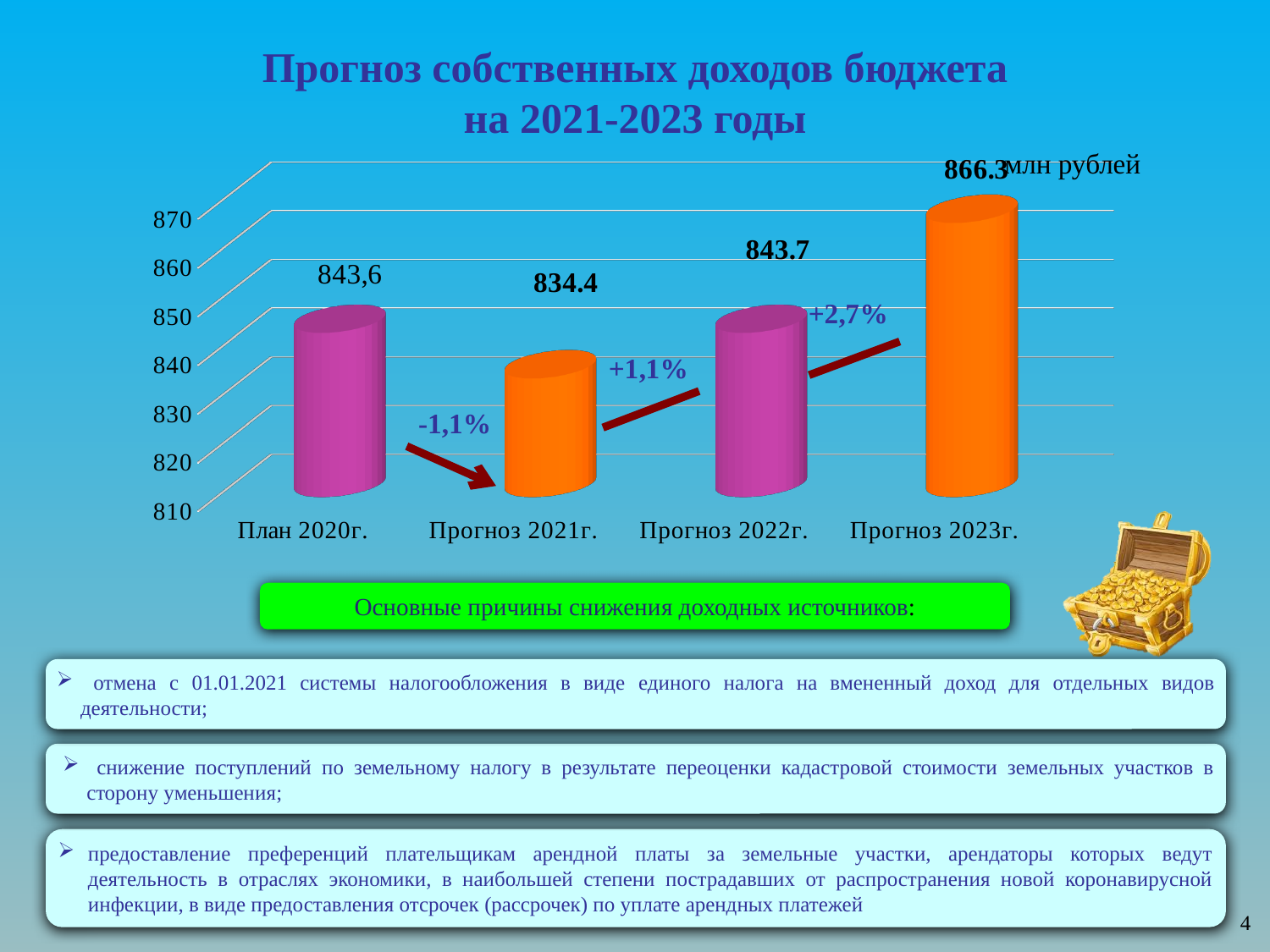
What kind of chart is shown on the slide? bar chart Which category has the highest value? Прогноз 2023г. What is the value for План 2020г.? 843,6 What percentage change is labelled between Прогноз 2022г. and Прогноз 2023г.? +2,7% What is the difference between the values for Прогноз 2023г. and Прогноз 2022г.? 22.6 How many categories are shown on the x axis? 4 What is the value for Прогноз 2023г.? 866.3 Which is larger, the value for Прогноз 2023г. or the value for Прогноз 2021г.? Прогноз 2023г. Is the value for Прогноз 2023г. greater or less than 860? greater Which category has the lowest value? Прогноз 2021г. What is the value for Прогноз 2021г.? 834.4 What is the difference between the values for Прогноз 2022г. and Прогноз 2021г.? 9.3